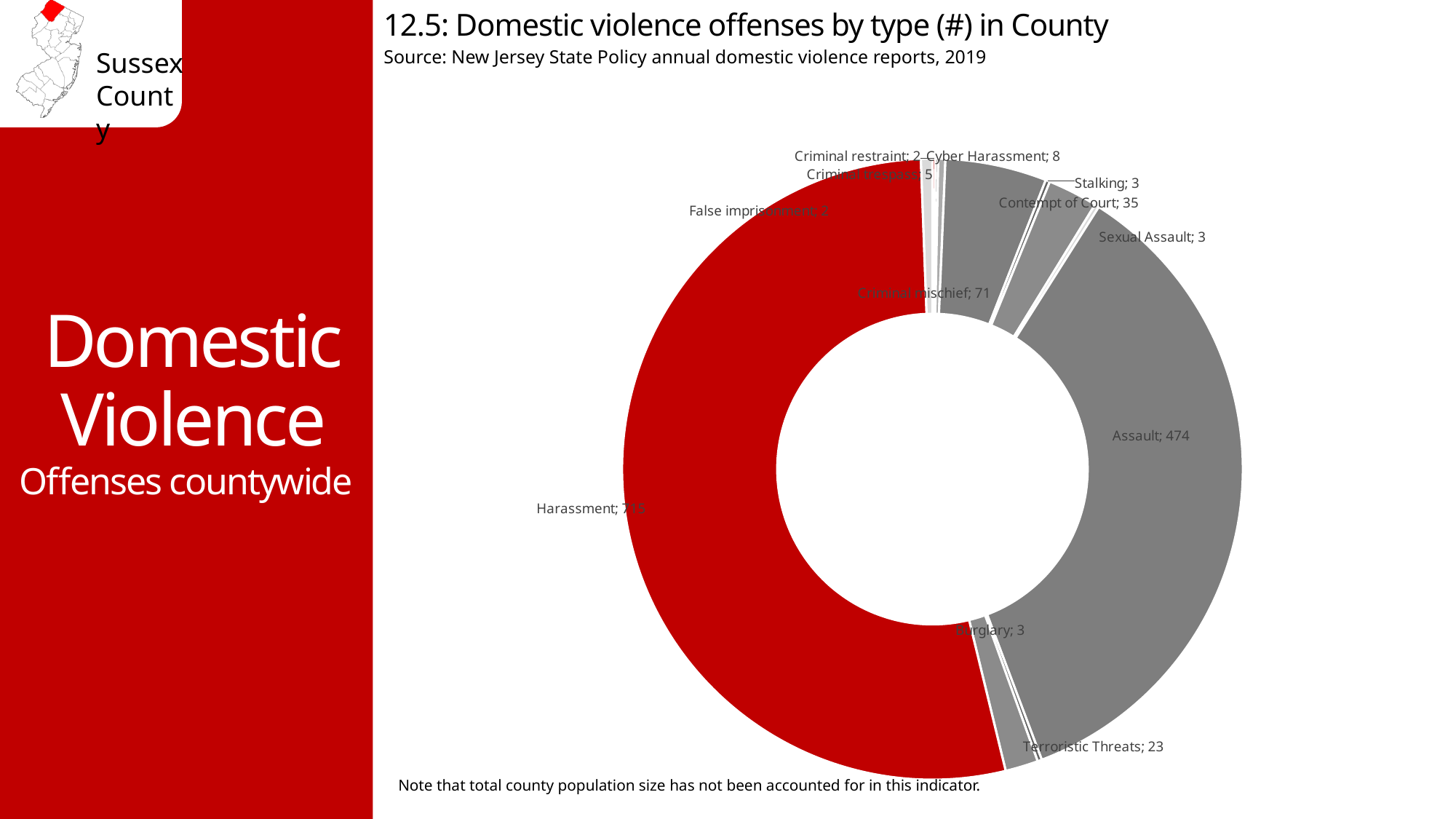
What is the value for Contempt of Court? 35 What is the difference between the Harassment and Assault counts? 241 What kind of chart is shown on the slide? Doughnut (pie) chart What is the value for Harassment? 715 How many offense types are shown in the chart? 12 What is the difference between the Criminal mischief and Contempt of Court counts? 36 How many domestic violence offenses of type Assault are shown? 474 Which is larger, Cyber Harassment or Criminal trespass? Cyber Harassment What colour is the Harassment slice? Red Which offense type has the highest count? Harassment What is the value for Criminal mischief? 71 What is the value for Terroristic Threats? 23